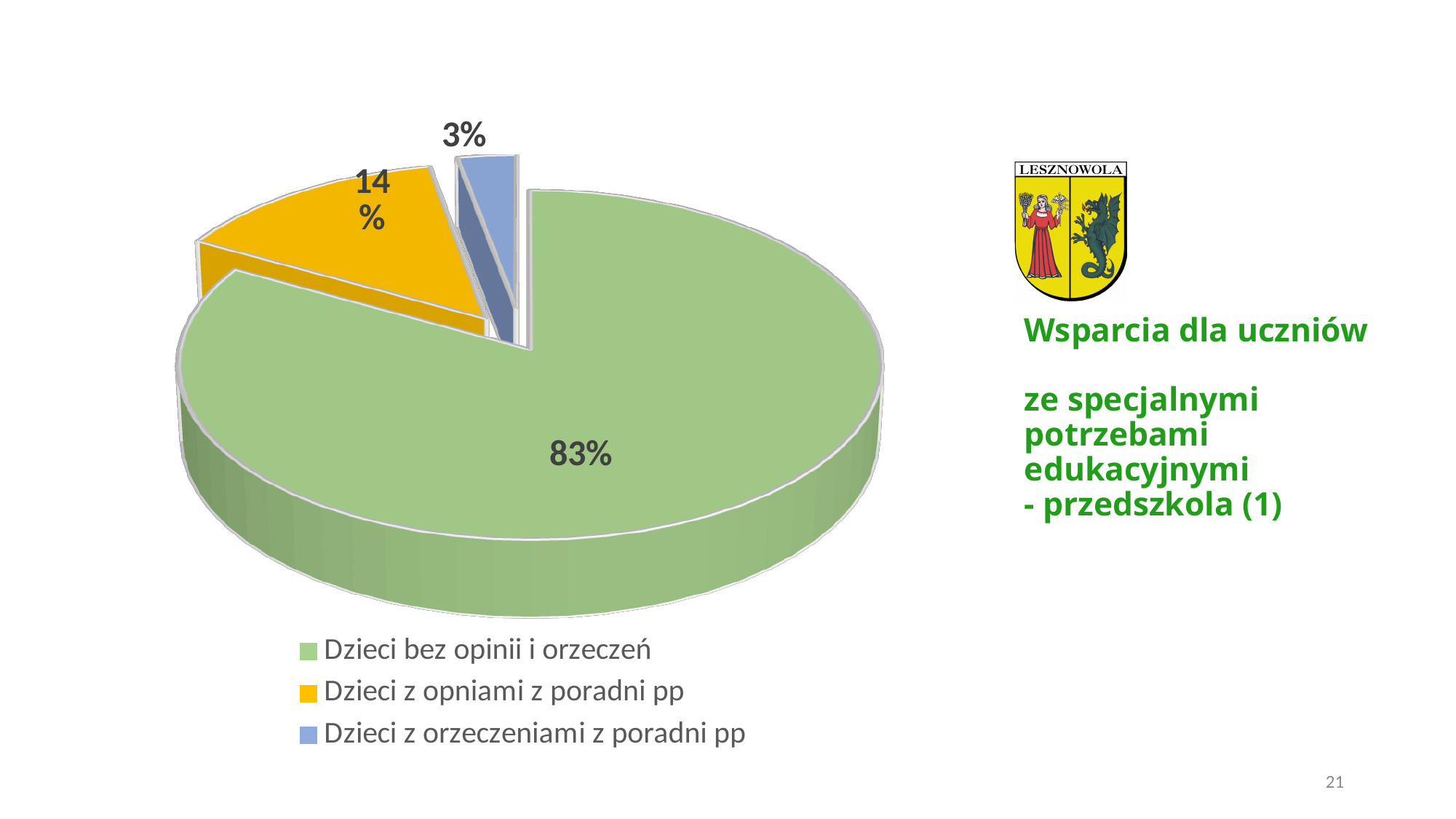
What share of the pie is 'Dzieci z opniami z poradni pp'? 14% Which is larger: the share for 'Dzieci z opniami z poradni pp' or for 'Dzieci z orzeczeniami z poradni pp'? Dzieci z opniami z poradni pp What kind of chart is shown on the slide? Pie chart What share of the pie is 'Dzieci z orzeczeniami z poradni pp'? 3% What share of the pie is 'Dzieci bez opinii i orzeczeń'? 83% What is the difference in percentage points between 'Dzieci z opniami z poradni pp' and 'Dzieci z orzeczeniami z poradni pp'? 11 percentage points Which category has the smallest slice of the pie? Dzieci z orzeczeniami z poradni pp What colour is the slice for 'Dzieci bez opinii i orzeczeń'? Green How many categories does the pie chart show? 3 What colour is the slice for 'Dzieci z opniami z poradni pp'? Yellow Which category has the largest slice of the pie? Dzieci bez opinii i orzeczeń What is the difference in percentage points between 'Dzieci bez opinii i orzeczeń' and 'Dzieci z opniami z poradni pp'? 69 percentage points